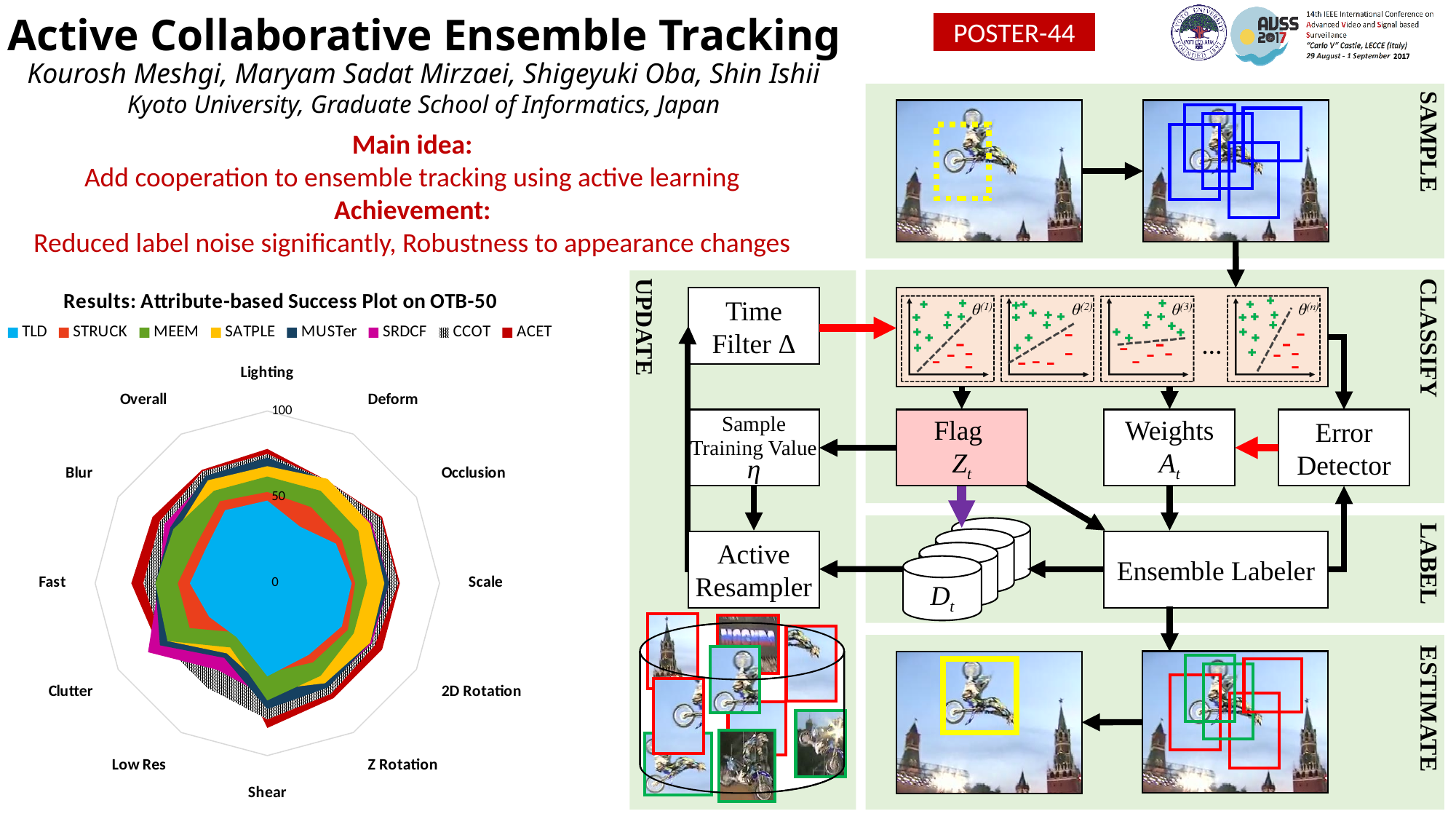
Is the value for MEEM on the Overall attribute greater or less than 100? less Is the value for ACET on the Fast attribute greater or less than 50? greater How many attribute categories are plotted around the radar chart? 12 Is the value for ACET on the Lighting attribute greater or less than 50? greater How many series does the chart's legend list? 8 What is the highest tick value shown on the radar chart's axis? 100 What is the title of the chart? Results: Attribute-based Success Plot on OTB-50 Which series is listed first in the chart's legend? TLD What kind of chart is shown on the slide? radar chart